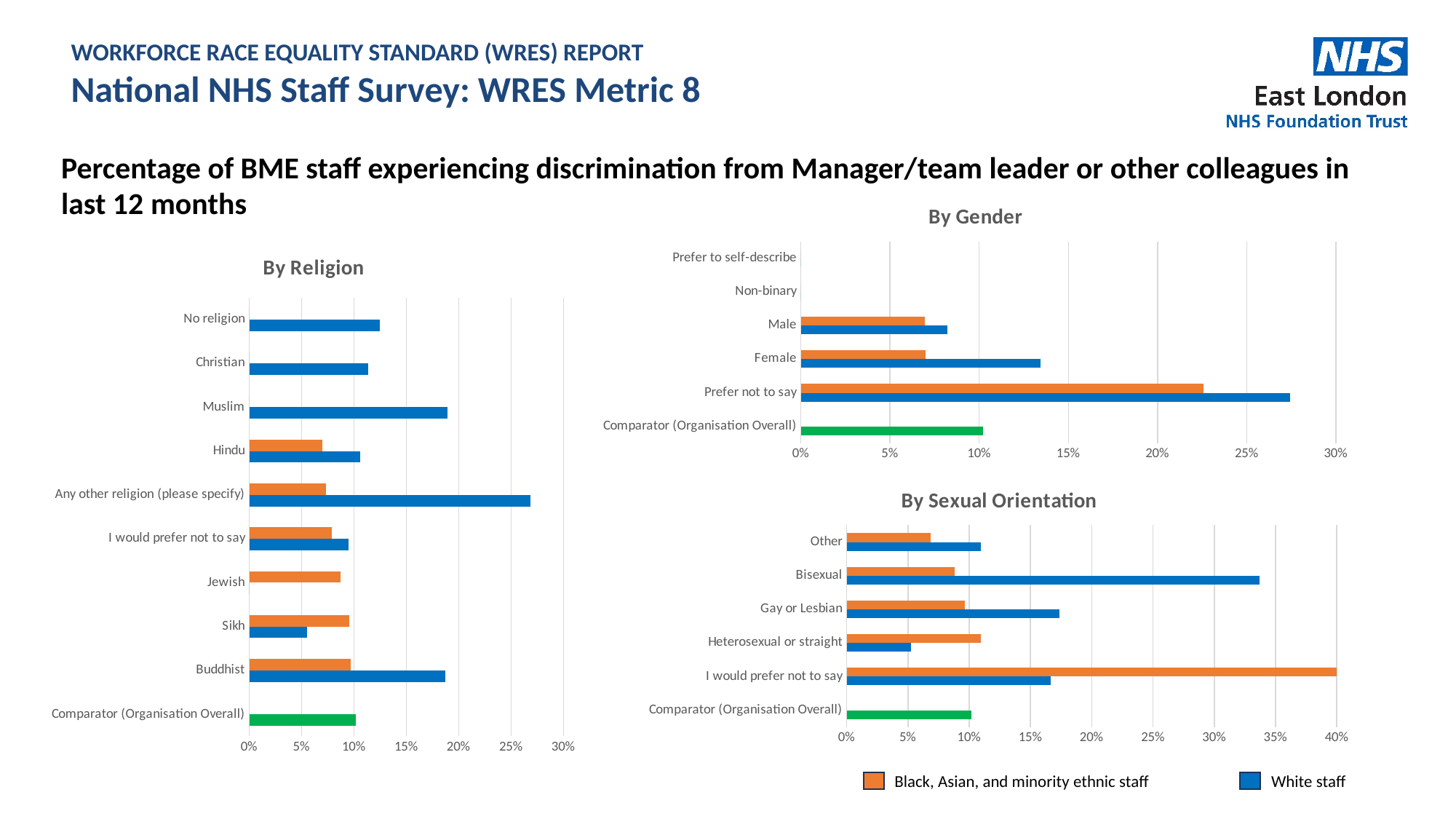
In the By Gender chart, for the Female category, which is larger: the value for Black, Asian, and minority ethnic staff or for White staff? White staff How many categories are shown on the y axis of the By Religion chart? 10 In the By Religion chart, for the Sikh category, which is larger: the value for Black, Asian, and minority ethnic staff or for White staff? Black, Asian, and minority ethnic staff How many series does the legend at the bottom of the slide list? 2 In the By Gender chart, which category has the highest value for White staff? Prefer not to say In the By Sexual Orientation chart, which category has the highest value for Black, Asian, and minority ethnic staff? I would prefer not to say In the By Religion chart, is the value for White staff in the Muslim category greater or less than 15%? greater In the By Gender chart, is the value for White staff in the Female category greater or less than 10%? greater In the By Religion chart, is the value for White staff in the Sikh category greater or less than 10%? less In the By Sexual Orientation chart, for the Heterosexual or straight category, which is larger: the value for Black, Asian, and minority ethnic staff or for White staff? Black, Asian, and minority ethnic staff In the By Religion chart, which category has the highest value for White staff? Any other religion (please specify)